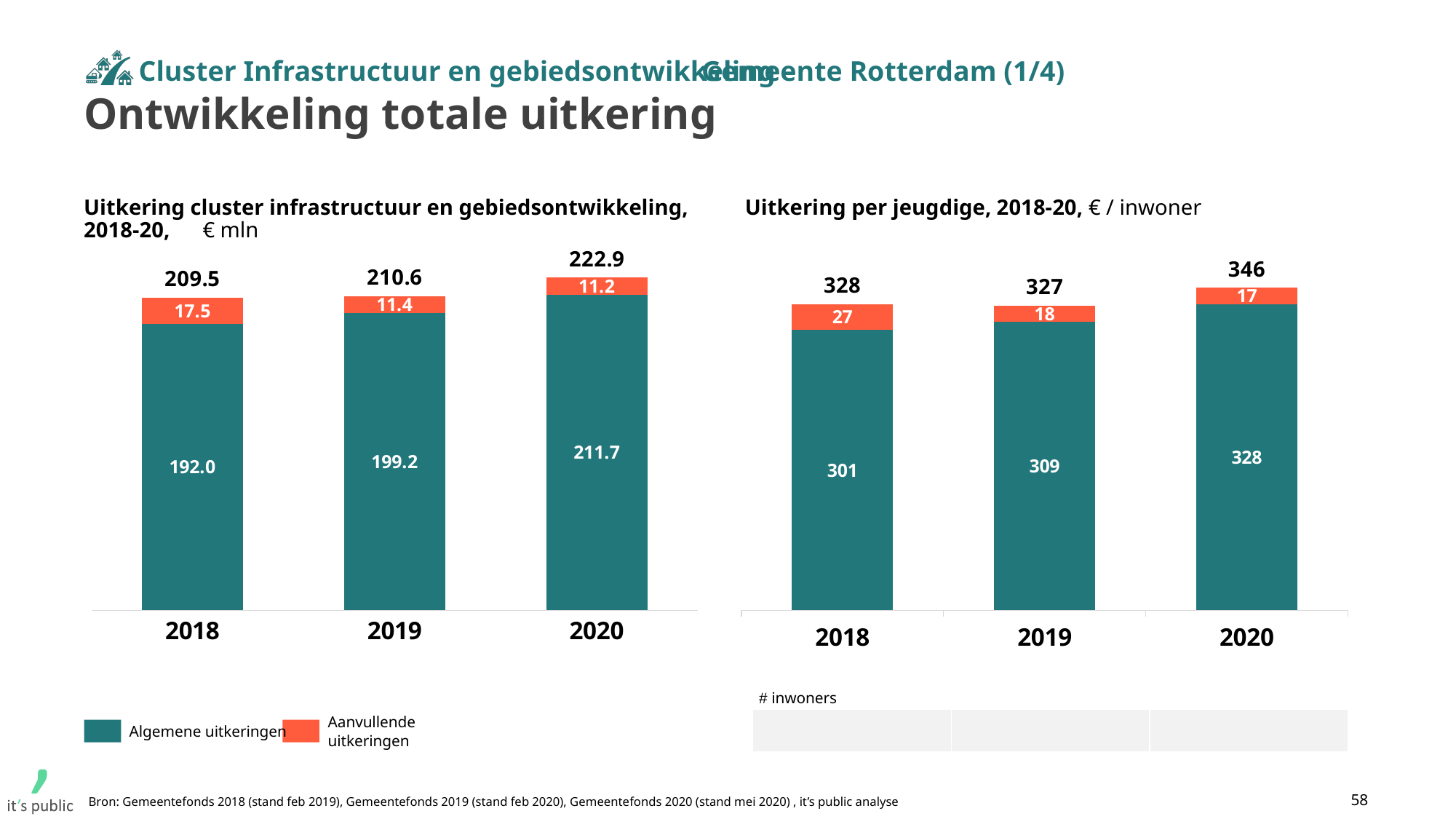
In the left chart (Uitkering cluster infrastructuur en gebiedsontwikkeling), what is the value of Algemene uitkeringen for 2018? 192.0 In the left chart (Uitkering cluster infrastructuur en gebiedsontwikkeling), what is the difference between the Aanvullende uitkeringen values for 2018 and 2019? 6.1 In the right chart (Uitkering per jeugdige), which year has the lowest total? 2019 How many series does the legend list for the left chart? 2 In the left chart (Uitkering cluster infrastructuur en gebiedsontwikkeling), do the Algemene uitkeringen values rise or fall from 2018 to 2020? rise In the left chart (Uitkering cluster infrastructuur en gebiedsontwikkeling), which year has the highest total? 2020 In the left chart (Uitkering cluster infrastructuur en gebiedsontwikkeling), what is the value of Aanvullende uitkeringen for 2020? 11.2 In the right chart (Uitkering per jeugdige), what is the difference between the totals for 2020 and 2018? 18 In the right chart (Uitkering per jeugdige), what is the value of Aanvullende uitkeringen for 2018? 27 In the right chart (Uitkering per jeugdige), what is the value of Algemene uitkeringen for 2019? 309 In the left chart (Uitkering cluster infrastructuur en gebiedsontwikkeling), what is the total of the stacked bar for 2019? 210.6 What kind of chart is the right chart (Uitkering per jeugdige)? stacked bar chart